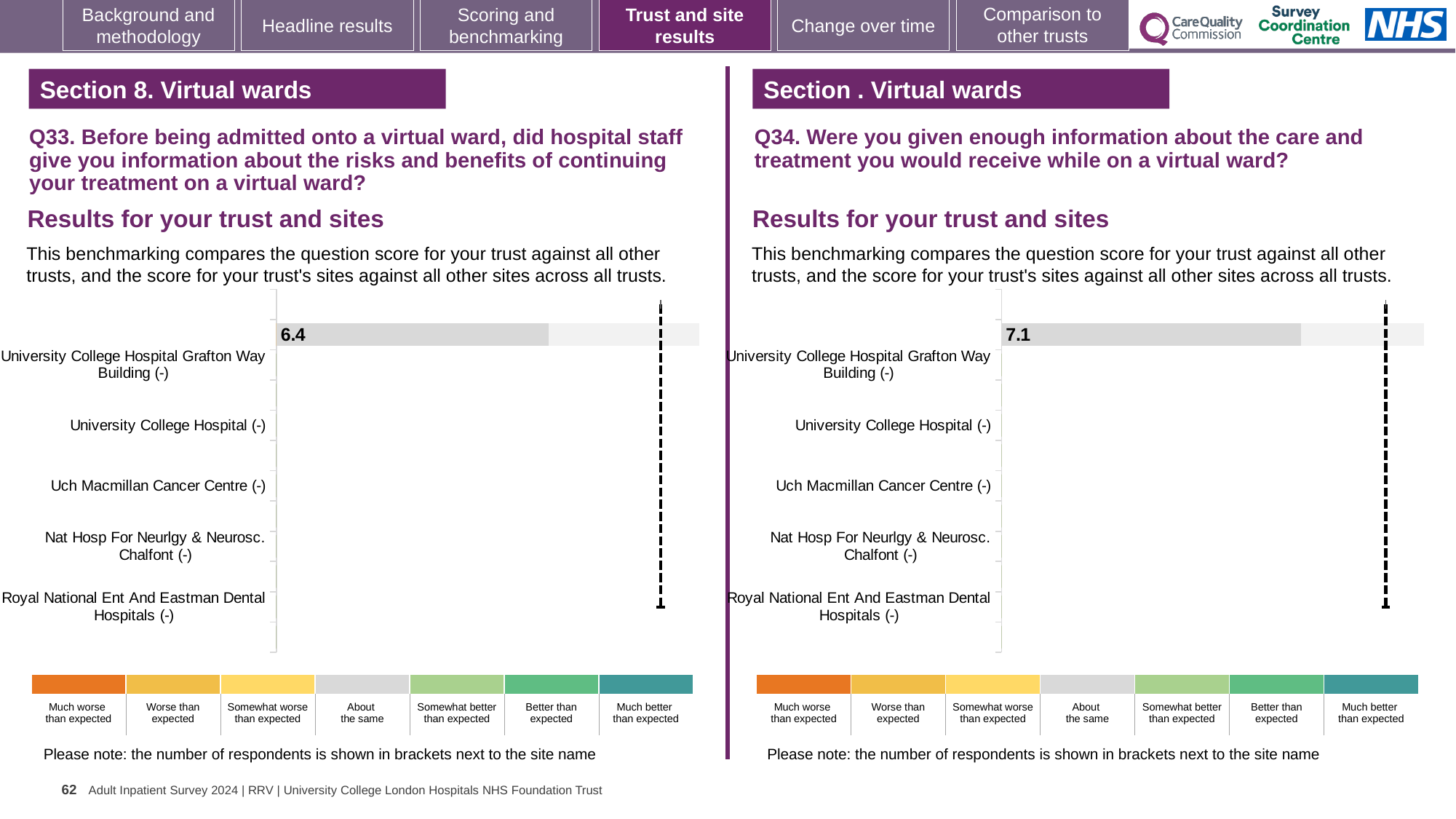
On the left chart (Q33), how many site names are listed on the vertical axis? 5 On the right chart (Q34), which site is listed last (at the bottom) on the vertical axis? Royal National Ent And Eastman Dental Hospitals (-) On the left chart (Q33), is the labelled bar value greater or less than 7? less What kind of chart is used on the left side of the slide for Q33? bar chart Which chart shows the higher labelled bar value, the left chart (Q33) or the right chart (Q34)? the right chart (Q34) On the left chart (Q33), which site is listed first (at the top) on the vertical axis? University College Hospital Grafton Way Building (-) On the right chart (Q34), what value is printed on the top bar? 7.1 How many categories does the colour key below the left chart (Q33) show? 7 On the right chart (Q34), how many site names are listed on the vertical axis? 5 On the right chart (Q34), is the labelled bar value greater or less than 7? greater What is the difference between the labelled bar value on the right chart (7.1) and the labelled bar value on the left chart (6.4)? 0.7 On the left chart (Q33), what value is printed on the top bar? 6.4